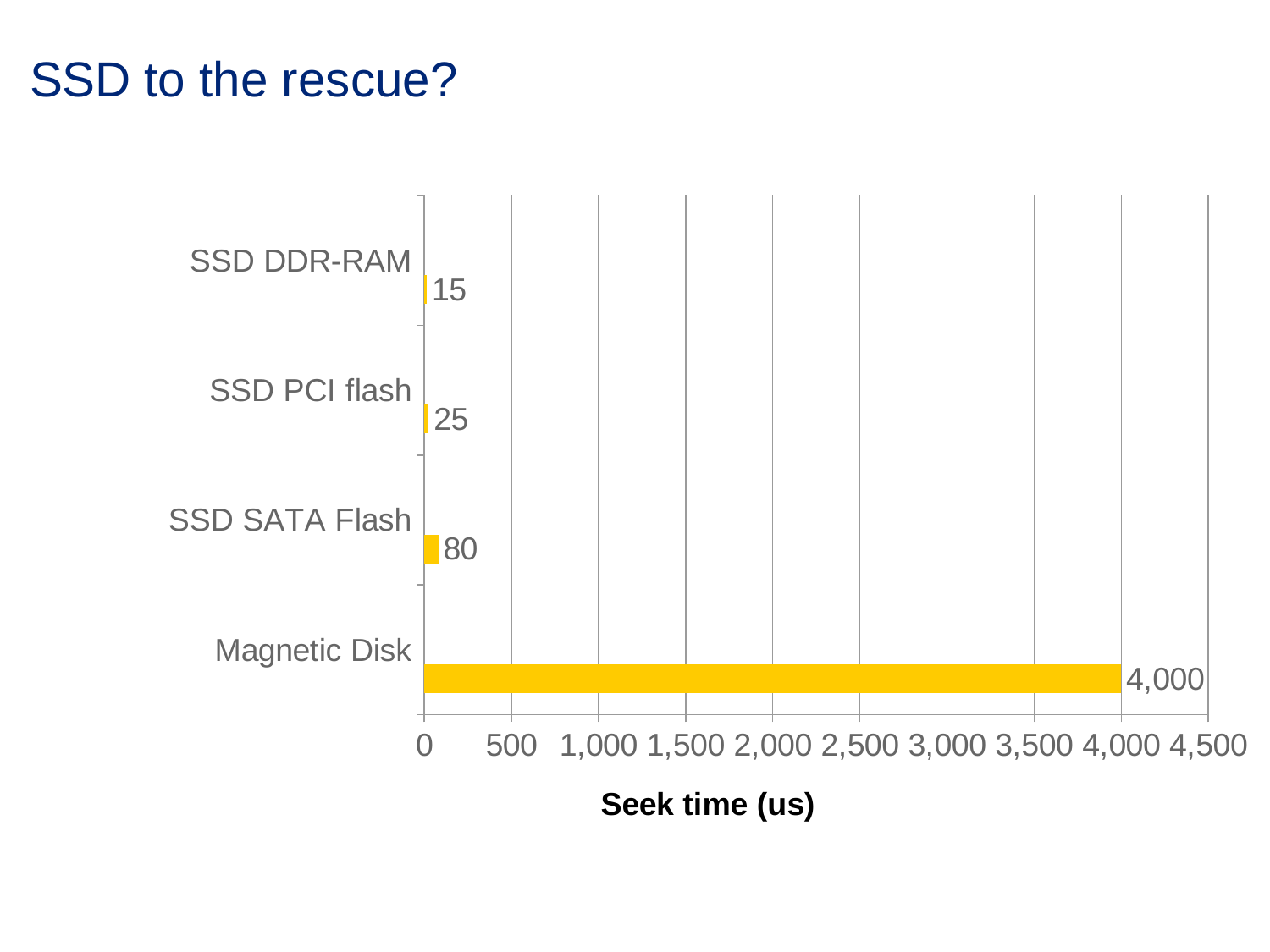
What is the difference in seek time between SSD SATA Flash and SSD PCI flash? 55 What is the difference in seek time between Magnetic Disk and SSD SATA Flash? 3,920 What is the label of the horizontal axis? Seek time (us) Which category has the lowest seek time? SSD DDR-RAM What kind of chart is shown on the slide? Bar chart How many categories are shown in the chart? 4 What is the seek time for Magnetic Disk? 4,000 What is the seek time for SSD PCI flash? 25 What is the seek time for SSD SATA Flash? 80 Which has a larger seek time, SSD PCI flash or SSD DDR-RAM? SSD PCI flash What is the seek time for SSD DDR-RAM? 15 Which category has the highest seek time? Magnetic Disk